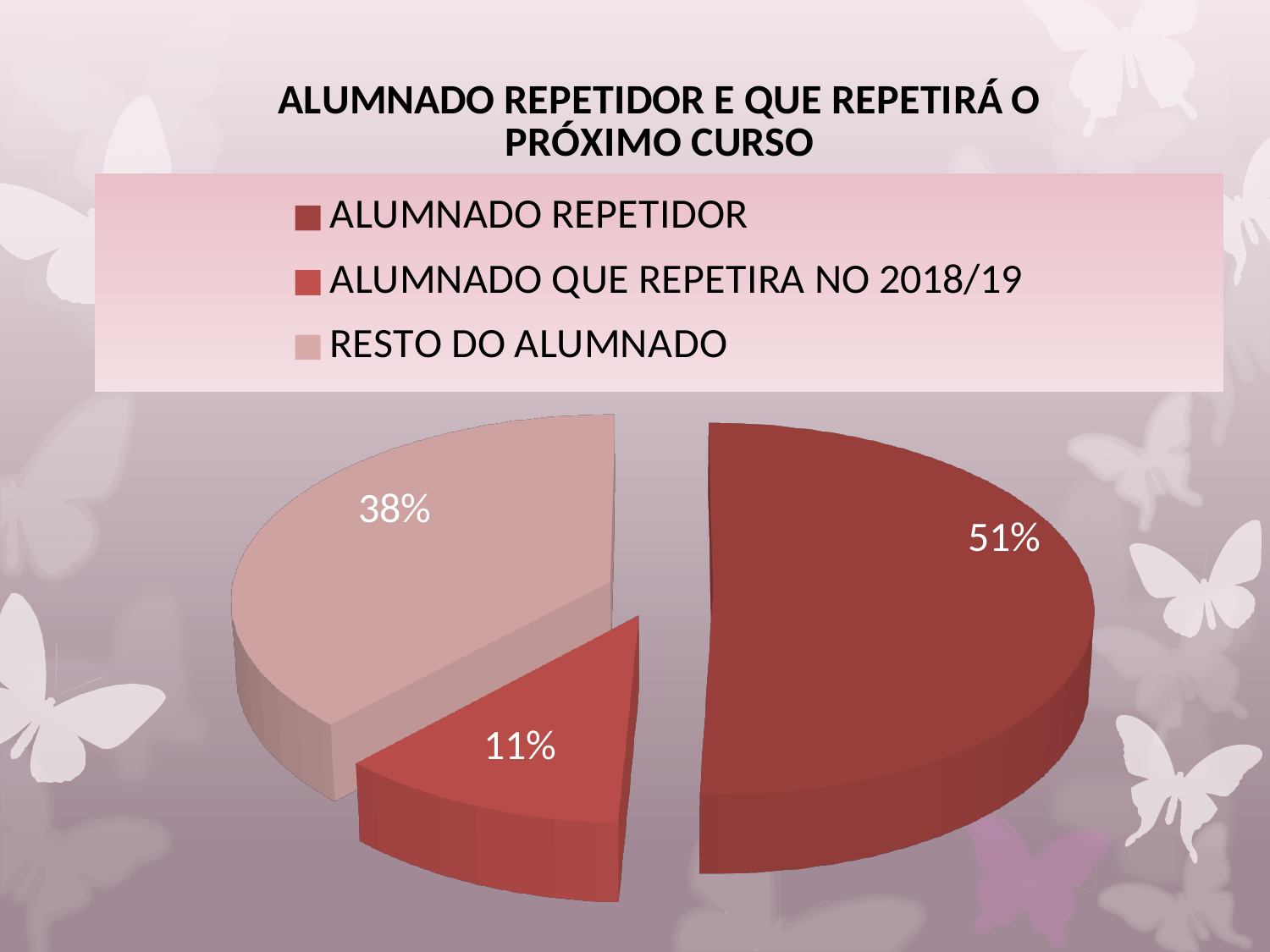
What share of the pie is RESTO DO ALUMNADO? 38% Which category has the smallest slice? ALUMNADO QUE REPETIRA NO 2018/19 Which is larger, the RESTO DO ALUMNADO slice or the ALUMNADO QUE REPETIRA NO 2018/19 slice? RESTO DO ALUMNADO How many entries does the legend list? 3 What share of the pie is ALUMNADO QUE REPETIRA NO 2018/19? 11% Which category has the largest slice? ALUMNADO REPETIDOR Which legend entry is shown in the lightest pink colour? RESTO DO ALUMNADO What kind of chart is shown on the slide? Pie chart What share of the pie is ALUMNADO REPETIDOR? 51% What is the difference between the ALUMNADO REPETIDOR share and the RESTO DO ALUMNADO share? 13% How many slices does the pie chart have? 3 What is the title of the chart? ALUMNADO REPETIDOR E QUE REPETIRÁ O PRÓXIMO CURSO